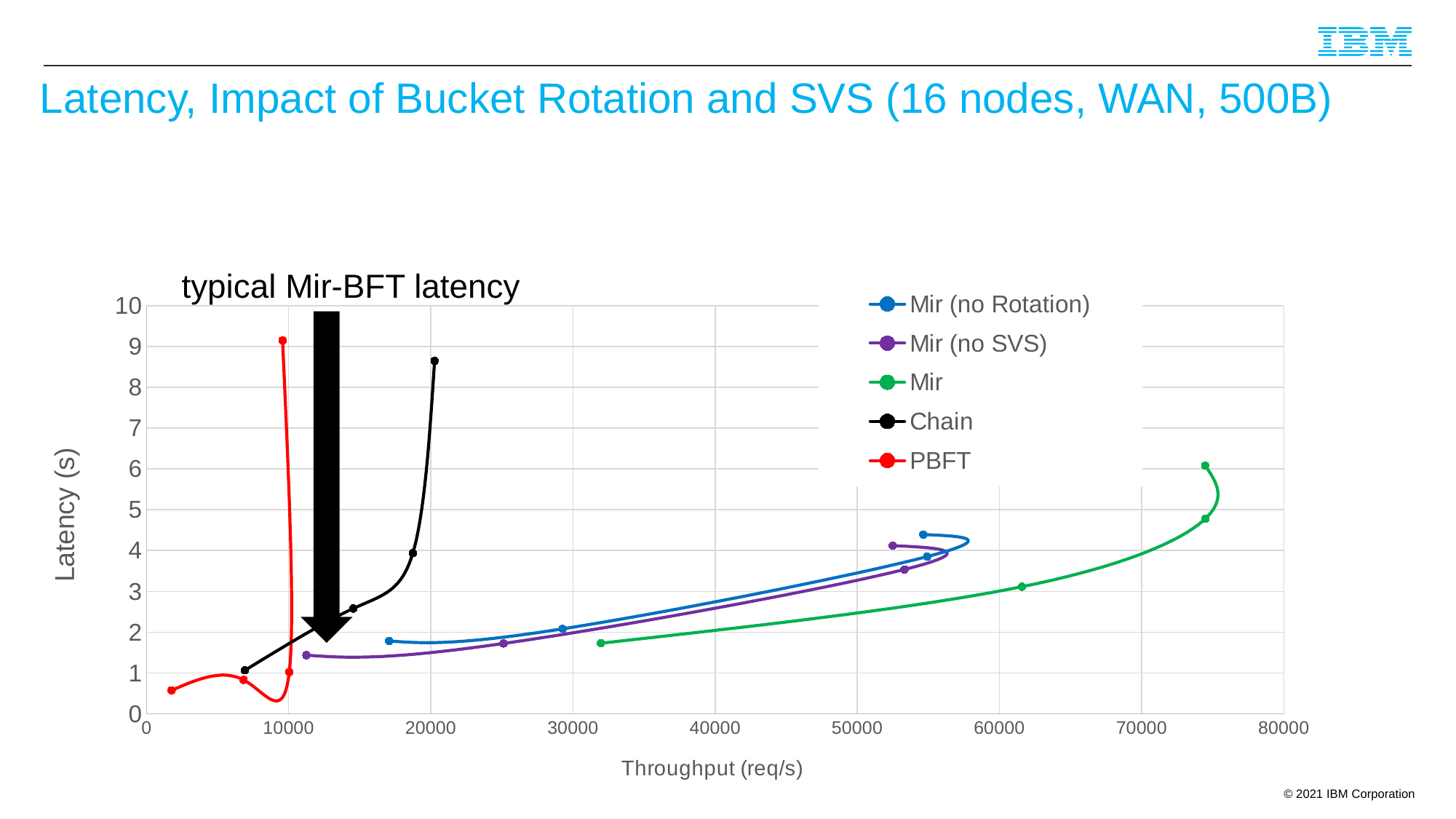
Which series reaches a higher latency, Chain or Mir (no Rotation)? Chain Is the highest latency reached by the PBFT series greater or less than 8? greater What is the label of the x axis? Throughput (req/s) Is the highest throughput reached by the Mir series greater or less than 70000? greater How many series does the legend list? 5 What kind of chart is shown on the slide? line chart Is the highest throughput reached by the Chain series greater or less than 30000? less Which series reaches a higher throughput, Chain or Mir (no SVS)? Mir (no SVS) Which series reaches the highest throughput? Mir Which series reaches the highest latency? PBFT What is the title of the chart? Latency, Impact of Bucket Rotation and SVS (16 nodes, WAN, 500B)